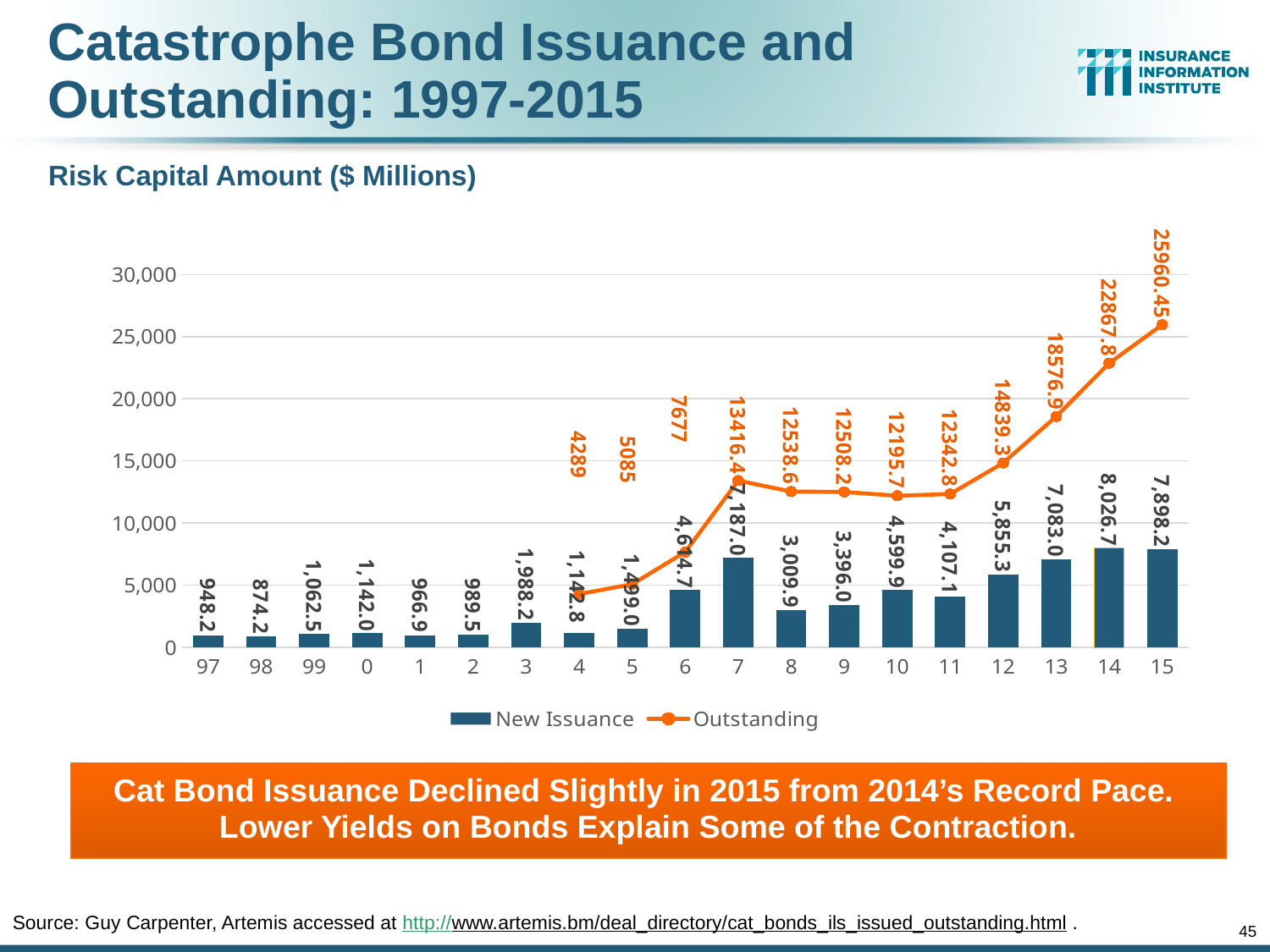
Which year has the lowest Outstanding value? 4 What is the Outstanding value for 7? 13416.4 Which year has the highest New Issuance value? 14 Which year has the lowest New Issuance value? 98 What is the New Issuance value for 97? 948.2 What is the Outstanding value for 15? 25960.45 How many years are shown on the x axis? 19 What is the New Issuance value for 14? 8,026.7 Does the Outstanding line rise or fall from 12 to 15? rise What is the difference between the New Issuance values for 14 and 15? 128.5 How many series does the legend list? 2 Which is larger, the New Issuance value for 7 or for 13? 7